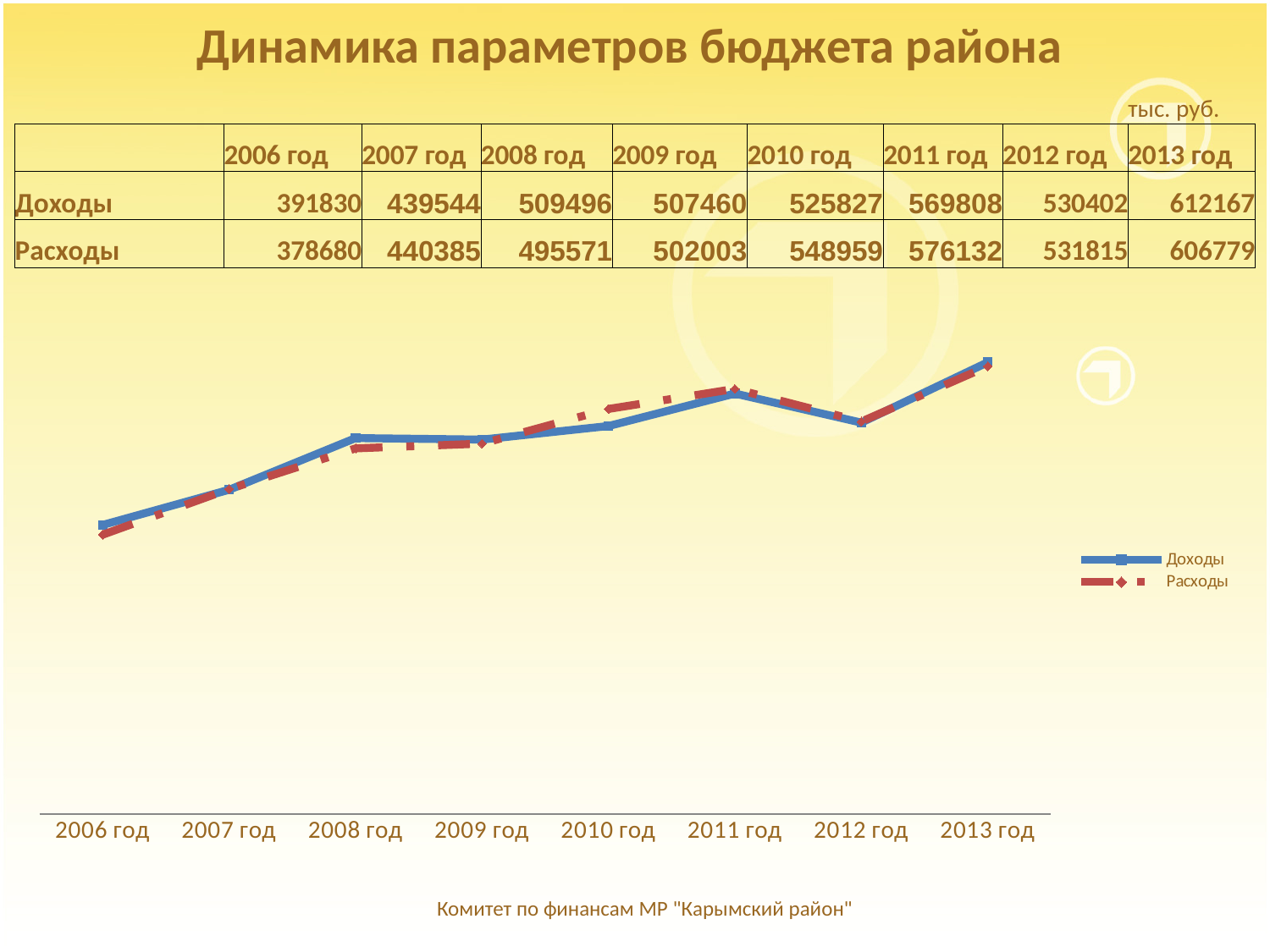
What kind of chart is shown? line chart What is the value of Доходы for 2008 год? 509496 How many series does the legend list? 2 What is the difference between Доходы and Расходы in 2013 год? 5388 In which year is Доходы highest? 2013 год Which is larger in 2012 год, Доходы or Расходы? Расходы What is the difference between Расходы and Доходы in 2010 год? 23132 What is the value of Расходы for 2011 год? 576132 Which is larger in 2010 год, Доходы or Расходы? Расходы How many years are plotted on the x axis? 8 In which year is Расходы lowest? 2006 год Do the Доходы values generally rise or fall from 2006 год to 2013 год? rise